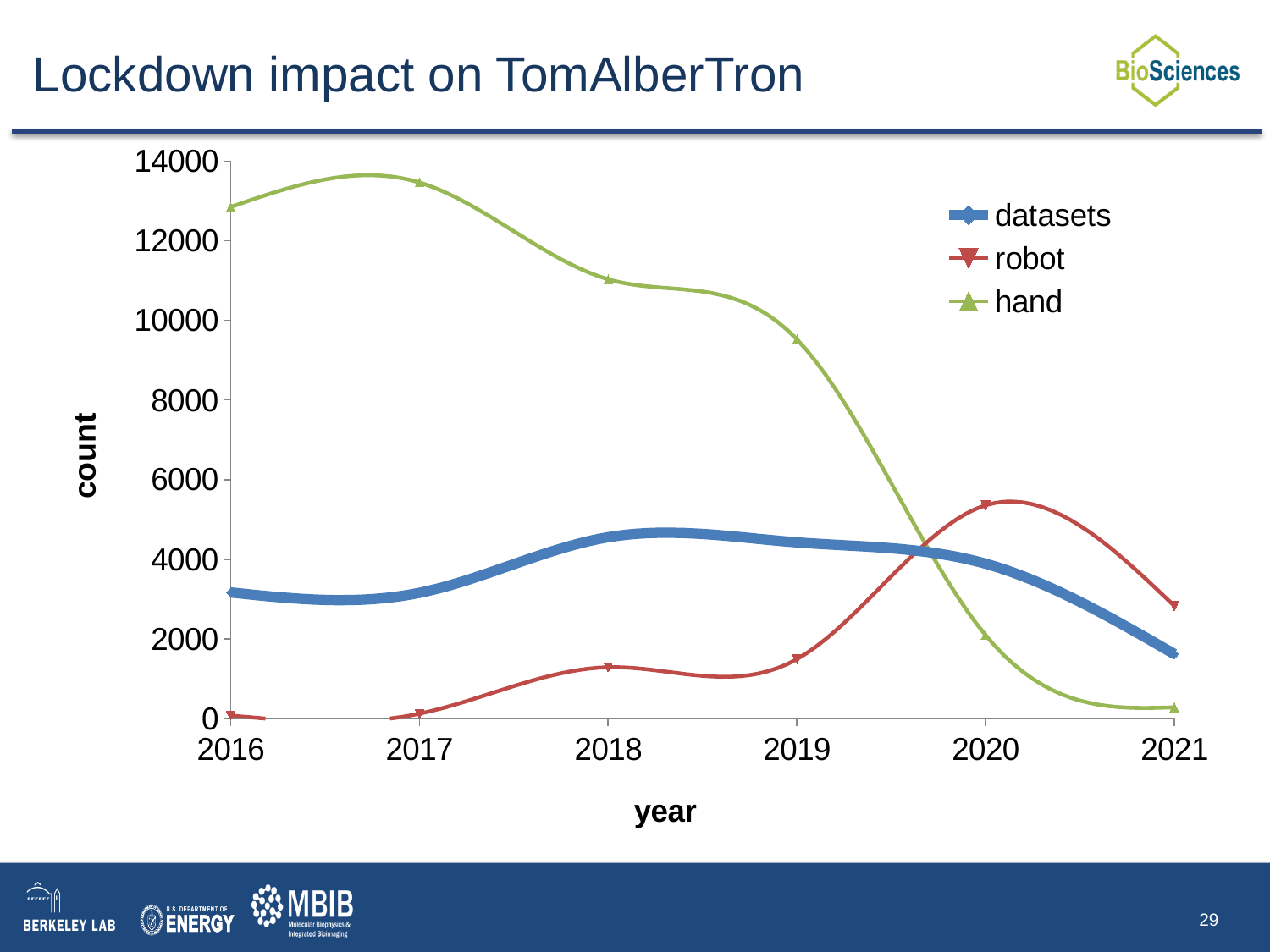
In 2021, which series has the larger value, robot or datasets? robot Is the value for hand in 2020 greater or less than 4000? less Is the value for robot in 2020 greater or less than 4000? greater Is the value for hand in 2019 greater or less than 8000? greater How many series does the legend list? 3 In which year does the hand series reach its lowest value? 2021 In which year does the robot series reach its highest value? 2020 Does the hand series rise or fall from 2017 to 2021? fall What kind of chart is shown on the slide? line chart What is the label on the x axis? year In which year does the hand series reach its highest value? 2017 How many years are plotted along the x axis? 6